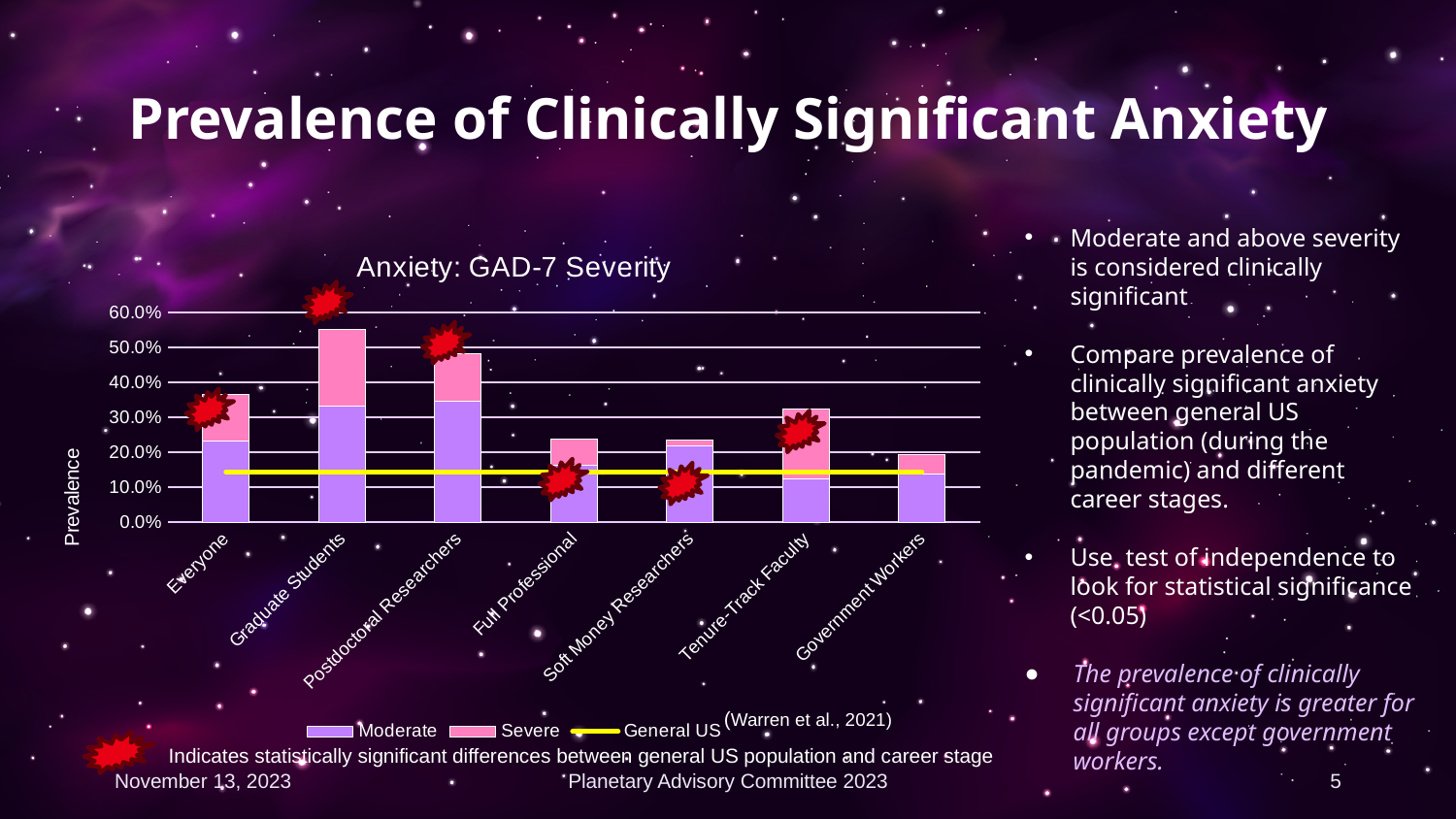
Is the total stacked bar for Government Workers greater or less than 30.0%? less Is the total stacked bar for Postdoctoral Researchers greater or less than 40.0%? greater What is the title of the chart? Anxiety: GAD-7 Severity How many career-stage categories are shown on the x axis of the chart? 7 Which category has the tallest stacked bar in the chart? Graduate Students Which category has the shortest stacked bar in the chart? Government Workers What kind of chart is shown on the slide? Stacked bar chart combined with a line (General US) What is the label of the y axis of the chart? Prevalence Is the total stacked bar for Graduate Students greater or less than 50.0%? greater Which has a taller stacked bar, Tenure-Track Faculty or Government Workers? Tenure-Track Faculty How many series does the chart's legend list? 3 Which has a taller stacked bar, Everyone or Full Professional? Everyone